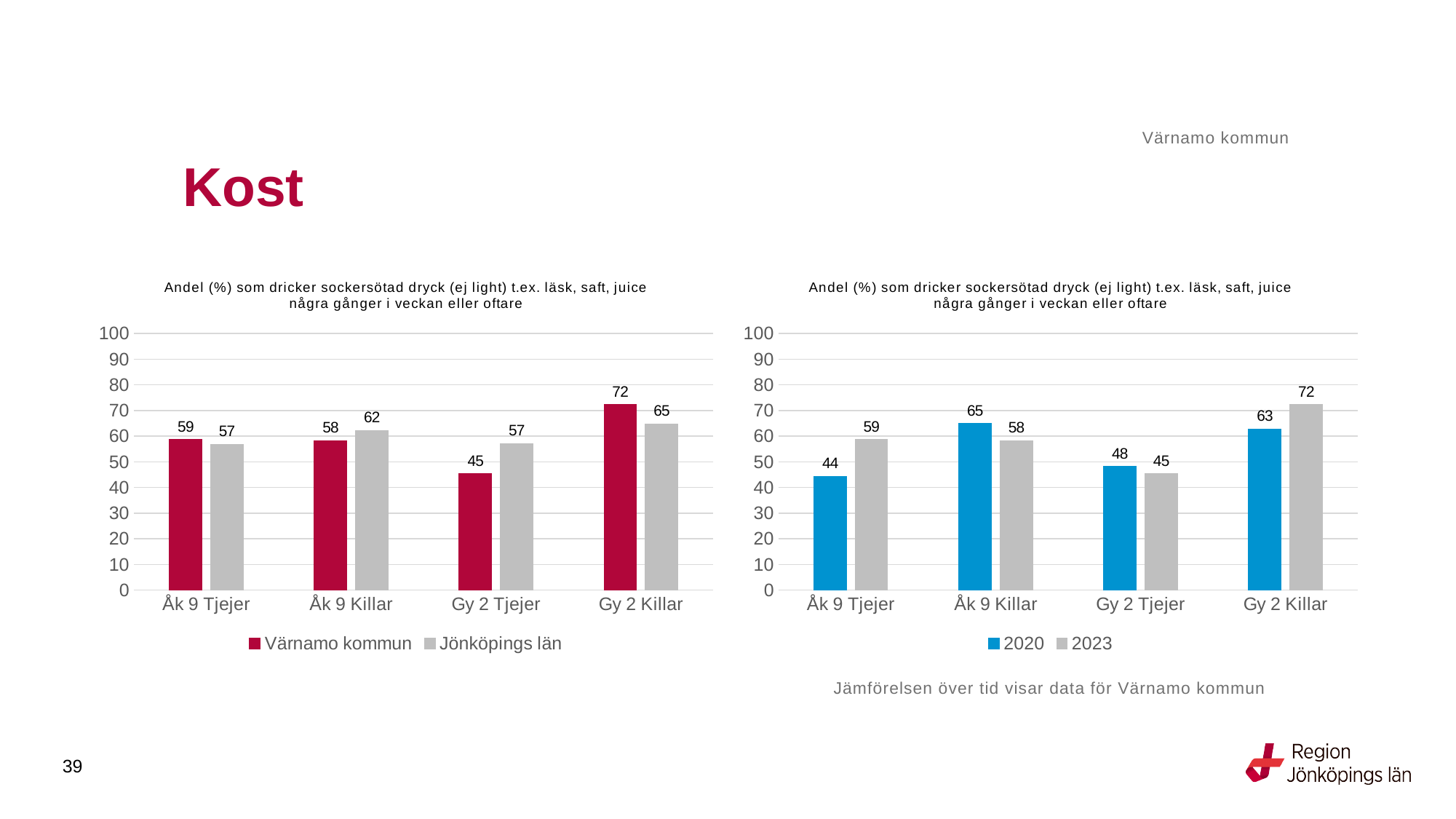
In the left chart, what is the difference between Värnamo kommun and Jönköpings län for Gy 2 Tjejer? 12 In the left chart, what is the value for Jönköpings län for Åk 9 Killar? 62 In the right chart, what is the difference between 2020 and 2023 for Åk 9 Tjejer? 15 In the right chart, what is the value for 2020 for Åk 9 Tjejer? 44 In the left chart, which category has the lowest value for Värnamo kommun? Gy 2 Tjejer How many categories are shown on the x axis of the left chart? 4 In the left chart, what is the value for Värnamo kommun for Gy 2 Killar? 72 In the right chart, which is larger for Åk 9 Killar: 2020 or 2023? 2020 In the right chart, what is the value for 2023 for Gy 2 Tjejer? 45 In the right chart, which category has the highest value for 2023? Gy 2 Killar What kind of chart is the left chart? bar chart How many series does the legend of the right chart list? 2